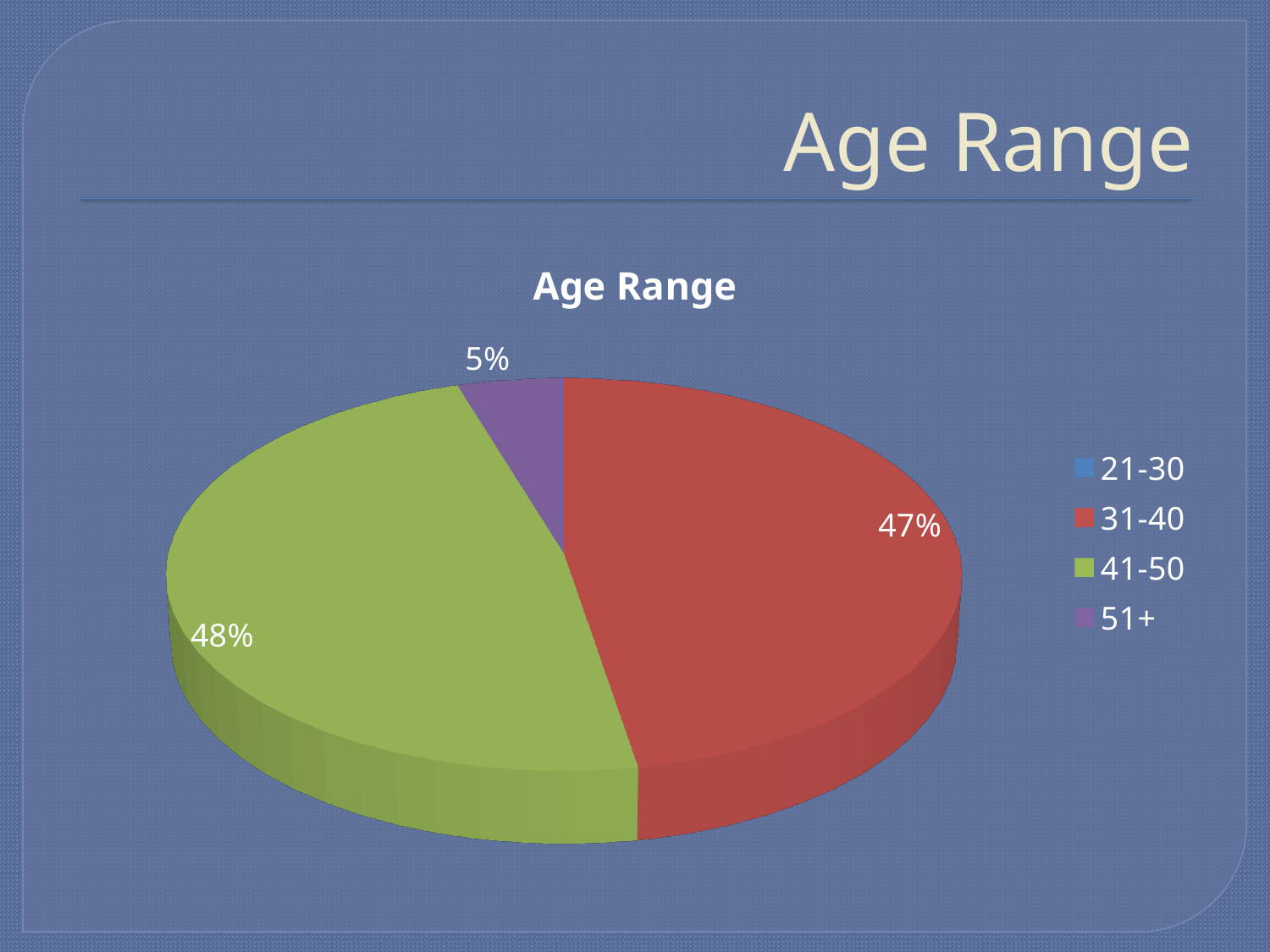
How many age ranges are listed in the chart's legend? 4 What percentage of the pie does the 31-40 age range represent? 47% What colour is the slice for the 41-50 age range? Green What percentage of the pie does the 51+ age range represent? 5% Which age range has the largest share of the pie? 41-50 What is the title of the chart? Age Range What type of chart is shown on the slide? Pie chart Which slice is larger, 31-40 or 51+? 31-40 What percentage of the pie does the 41-50 age range represent? 48% What is the difference in percentage points between the 31-40 and 51+ slices? 42% What is the difference in percentage points between the 41-50 and 31-40 slices? 1% Which labelled age range has the smallest share of the pie? 51+